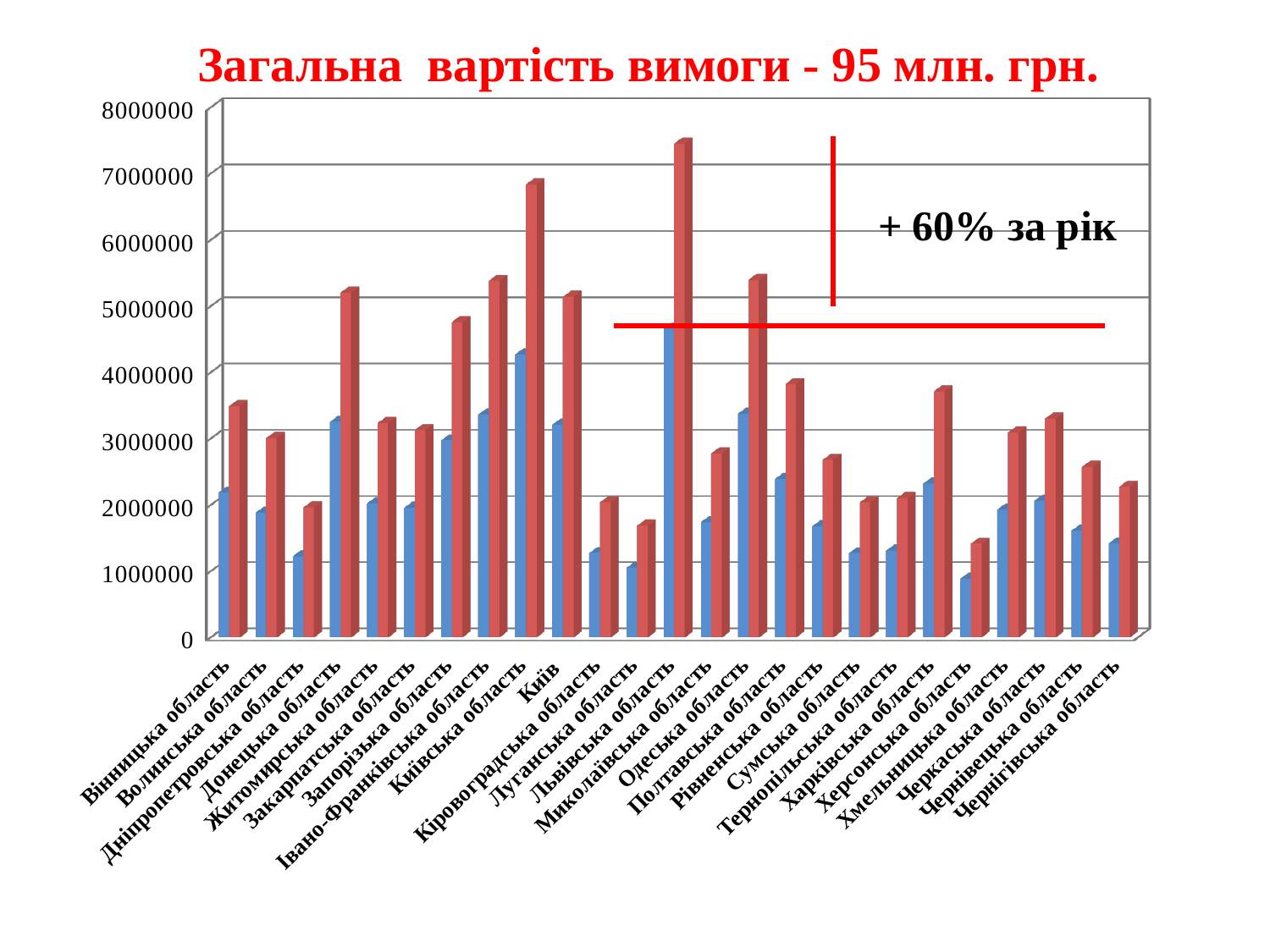
What kind of chart is shown on the slide? bar chart Which region has the tallest blue bar? Львівська область Which region has the tallest red bar? Львівська область Is the blue bar for Київська область greater or less than 4000000? greater Which region has the shortest red bar? Херсонська область Which region has the taller red bar, Київська область or Одеська область? Київська область Which region has the shortest blue bar? Херсонська область How many regions (categories) are shown on the x axis? 25 What annotation is written in the upper right area of the chart? + 60% за рік Is the red bar for Хмельницька область greater or less than 2000000? greater Is the red bar for Львівська область greater or less than 7000000? greater What is the title of the chart? Загальна вартість вимоги - 95 млн. грн.